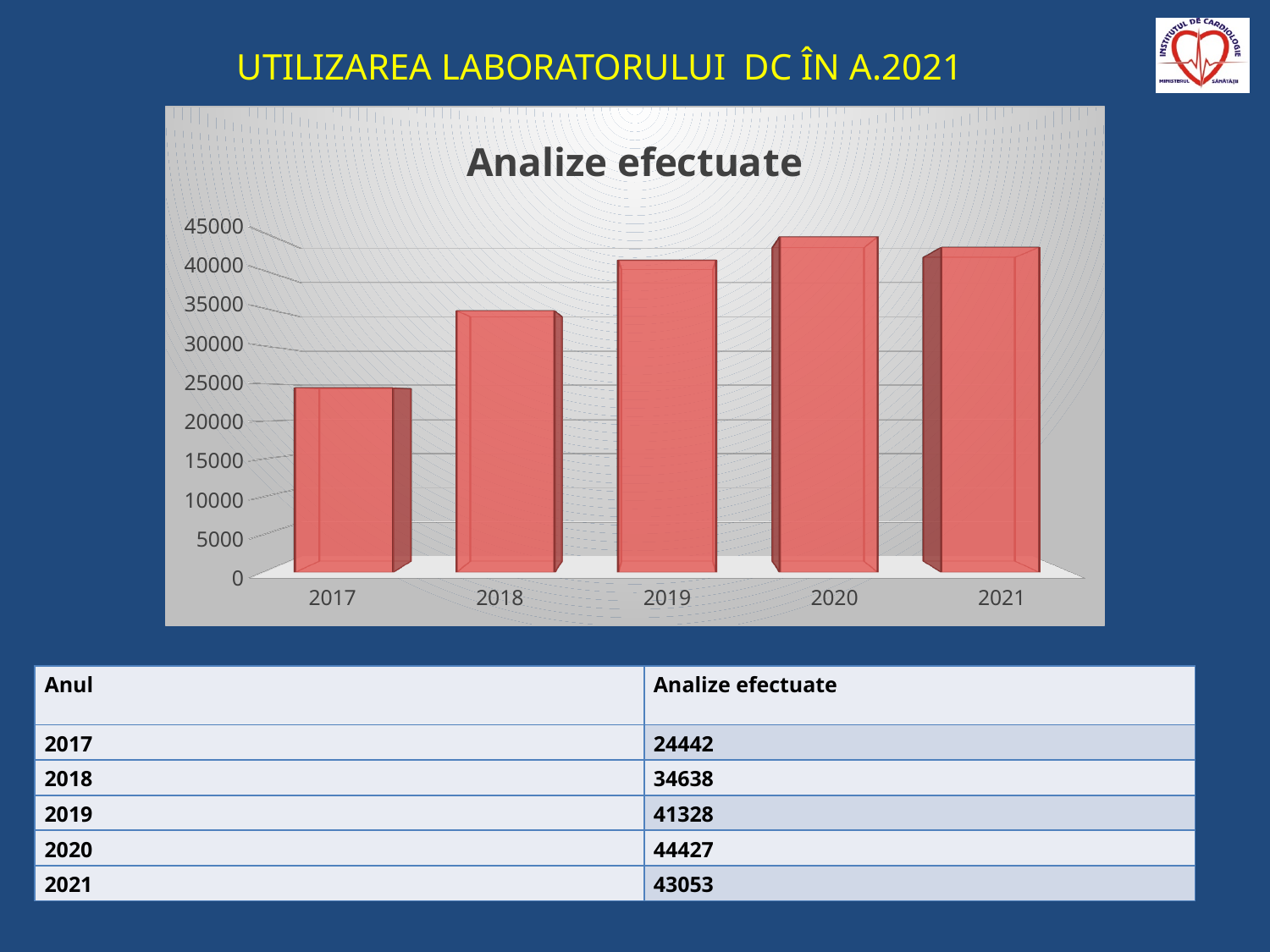
Which is larger, the value for 2018 or the value for 2019? 2019 Which year has the lowest number of analize efectuate? 2017 What is the difference between the values for 2020 and 2021? 1374 What is the difference between the values for 2018 and 2017? 10196 What is the value of analize efectuate for 2019? 41328 Which year has the highest number of analize efectuate? 2020 What is the value of analize efectuate for 2021? 43053 What is the value of analize efectuate for 2017? 24442 Is the value for 2018 greater or less than 30000? greater What kind of chart is shown on the slide? bar chart What is the title of the chart? Analize efectuate How many years are plotted in the chart? 5